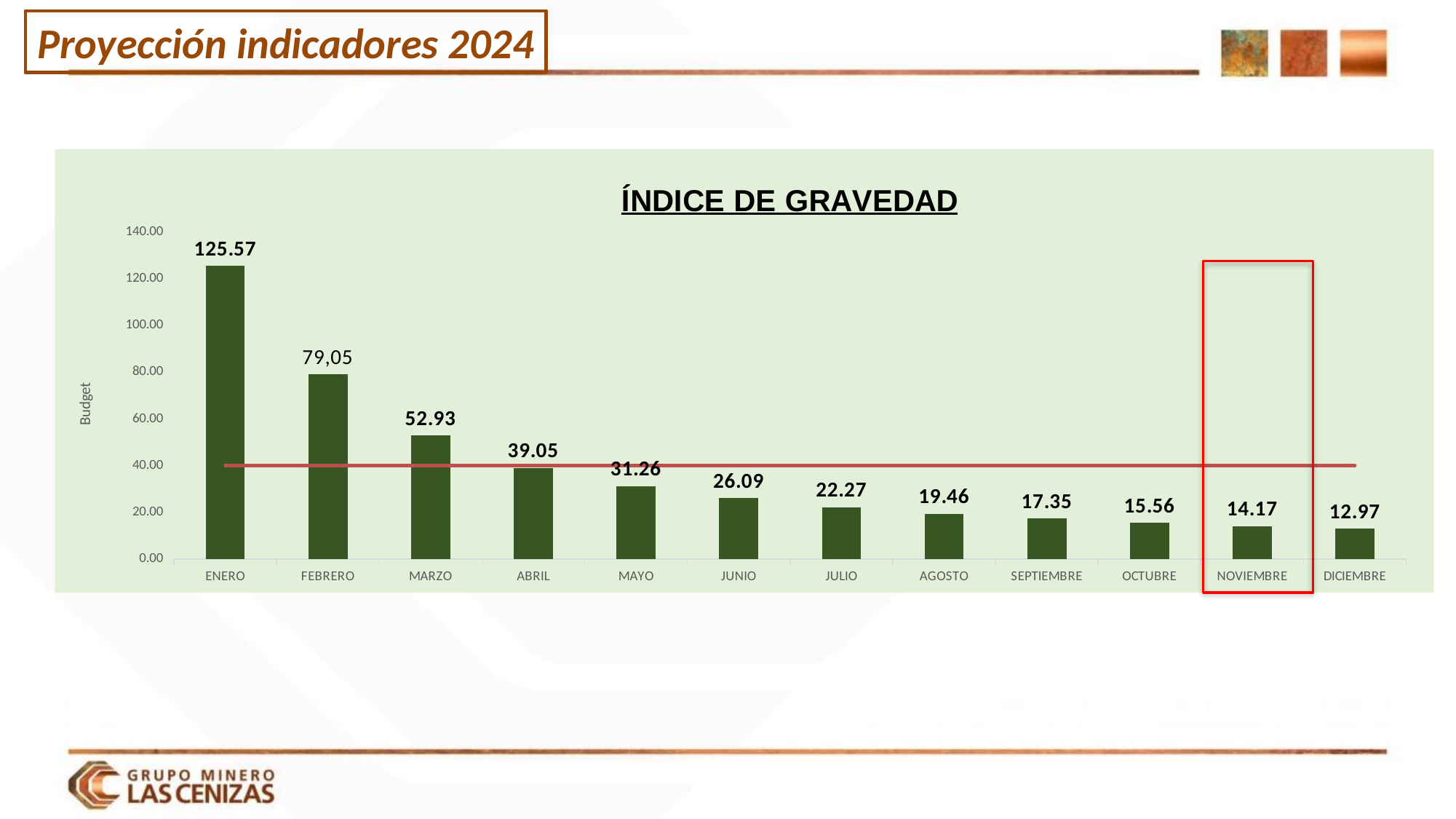
What is the difference between the values for MARZO and ABRIL in the ÍNDICE DE GRAVEDAD chart? 13.88 What is the difference between the values for JULIO and AGOSTO in the ÍNDICE DE GRAVEDAD chart? 2.81 Is the value for ABRIL in the ÍNDICE DE GRAVEDAD chart greater or less than 40.00? less What kind of chart is the ÍNDICE DE GRAVEDAD chart? combination bar and line chart How many months are shown on the x axis of the ÍNDICE DE GRAVEDAD chart? 12 Which month has the highest value in the ÍNDICE DE GRAVEDAD chart? ENERO What is the value for ENERO in the ÍNDICE DE GRAVEDAD chart? 125.57 Which month has the lowest value in the ÍNDICE DE GRAVEDAD chart? DICIEMBRE What is the value for NOVIEMBRE in the ÍNDICE DE GRAVEDAD chart? 14.17 Do the values in the ÍNDICE DE GRAVEDAD chart rise or fall from ENERO to DICIEMBRE? fall What is the value for FEBRERO in the ÍNDICE DE GRAVEDAD chart? 79,05 Which is larger in the ÍNDICE DE GRAVEDAD chart, the value for MAYO or the value for JUNIO? MAYO